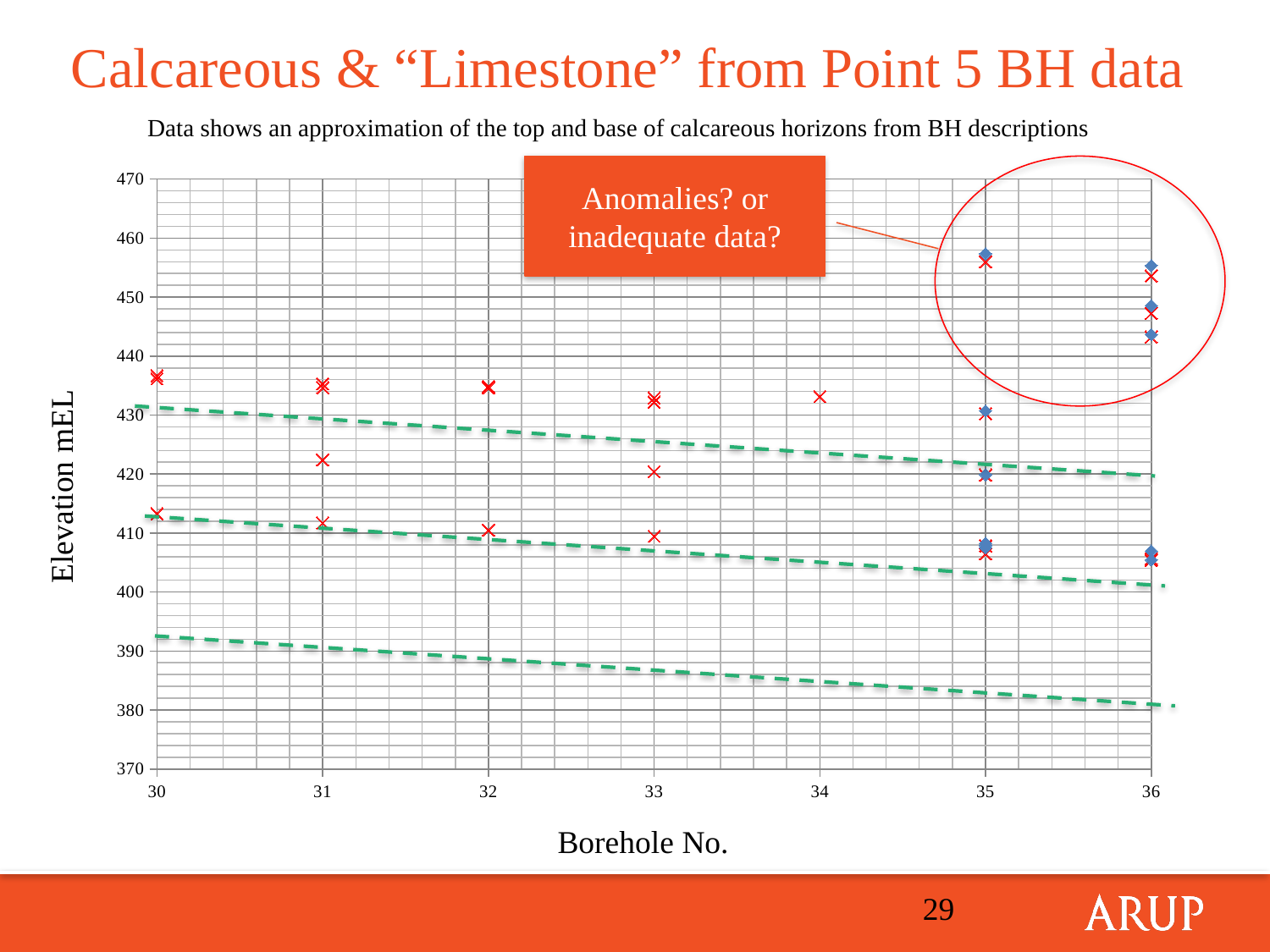
What kind of chart is shown on the slide? Scatter chart Is the lowest point plotted at borehole 30 greater or less than 420? less Is the highest point plotted at borehole 32 greater or less than 430? greater What is the title of the y axis of the chart? Elevation mEL Is the lowest point plotted at borehole 36 greater or less than 410? less Do the green dashed trend lines rise or fall from borehole 30 to borehole 36? Fall How many borehole numbers are labelled along the x axis? 7 What is the title of the x axis of the chart? Borehole No.